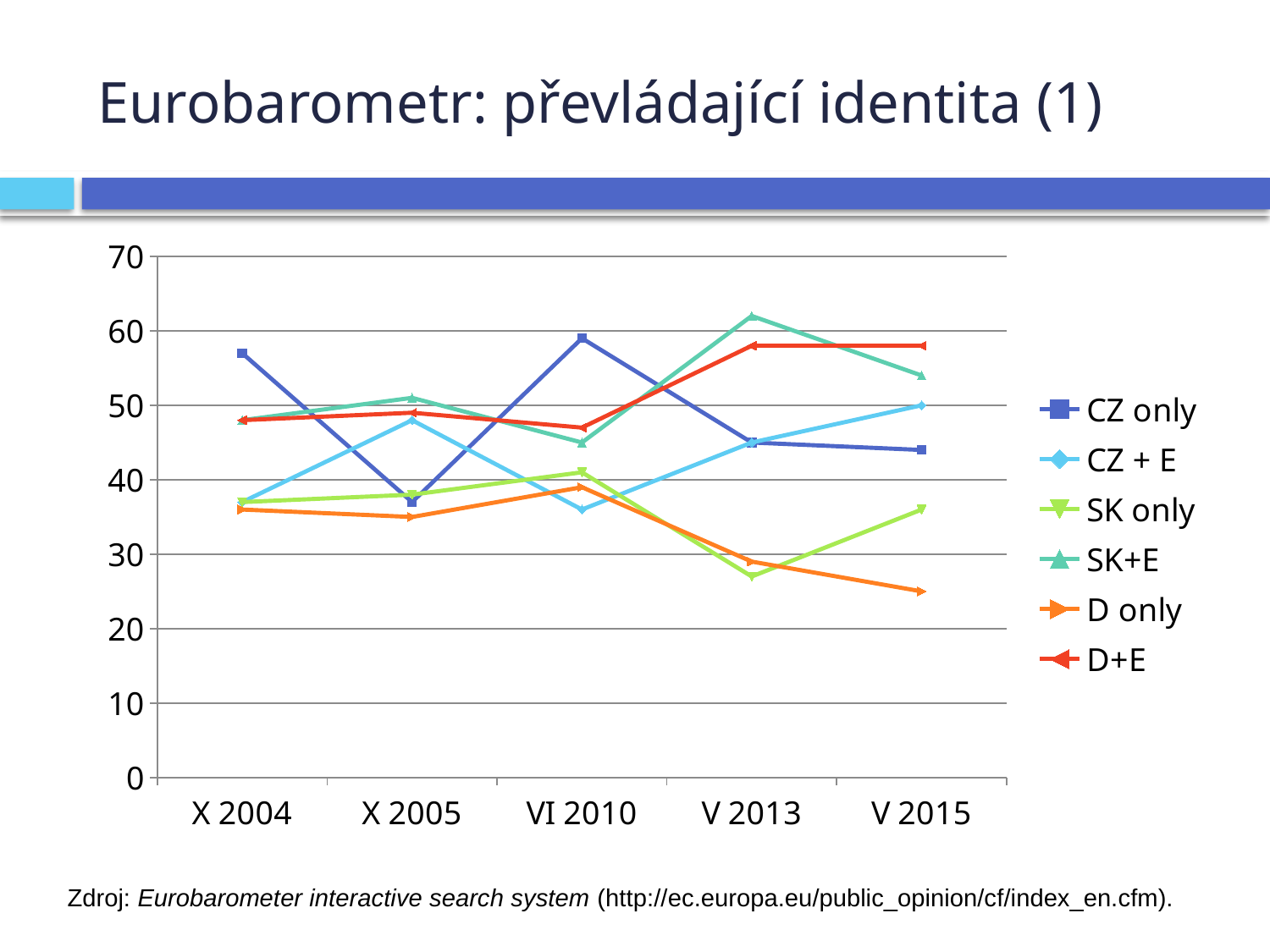
Which series has the highest value at V 2013? SK+E How many time points are shown on the x axis? 5 What kind of chart is shown on the slide? line chart How many series does the legend list? 6 What is the title of the slide containing the chart? Eurobarometr: převládající identita (1) Which series has the lowest value at V 2015? D only Is the value for SK+E at V 2013 greater or less than 60? greater Is the value for CZ only at X 2004 greater or less than 50? greater Is the value for D only at V 2015 greater or less than 30? less Does the D only series rise or fall from VI 2010 to V 2015? fall At X 2005, which is larger: CZ only or CZ + E? CZ + E